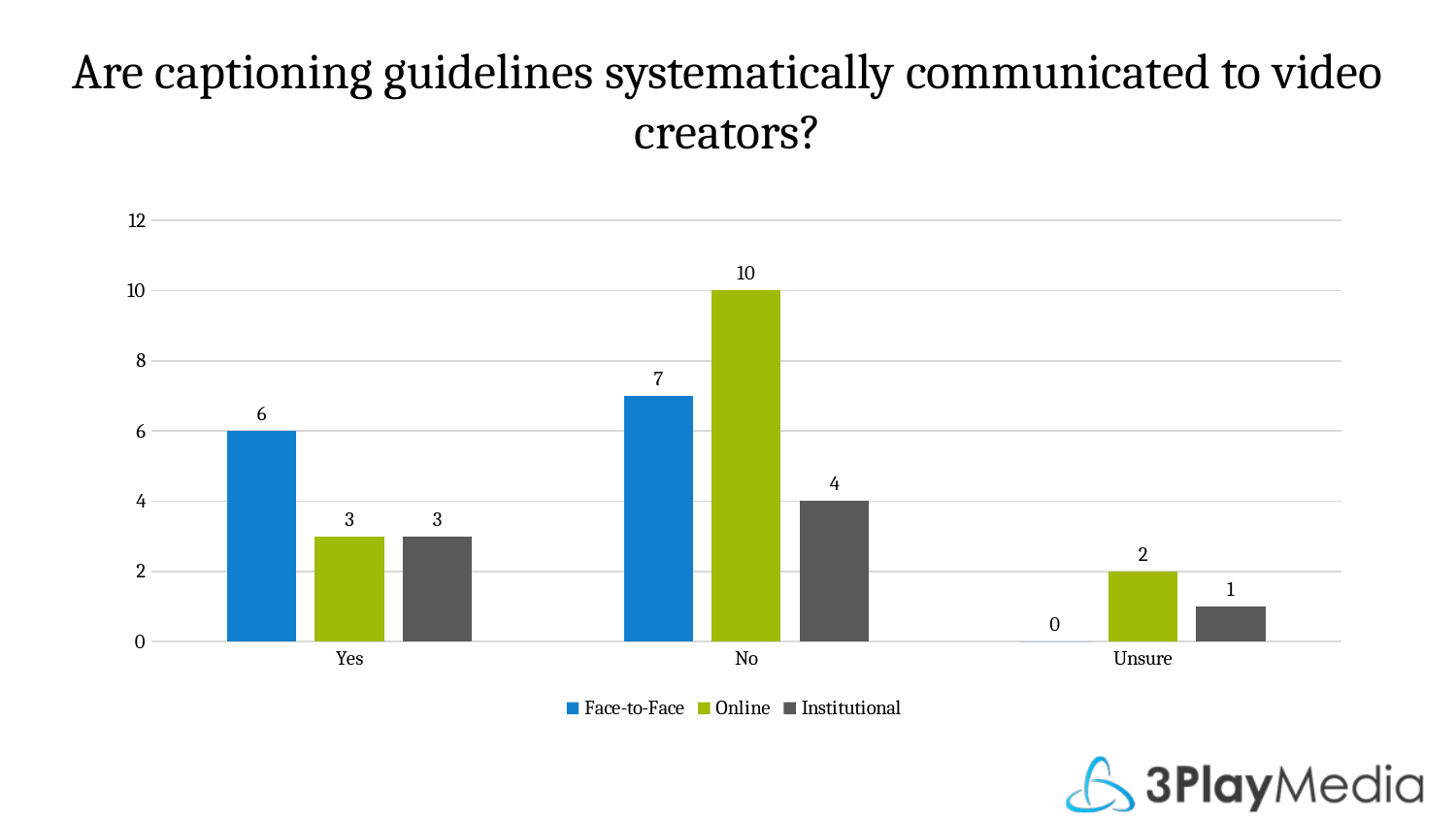
What is the value for Face-to-Face in the Unsure category? 0 Which category has the lowest value for the Face-to-Face series? Unsure Which category has the highest value for the Online series? No What is the title of the chart? Are captioning guidelines systematically communicated to video creators? How many series does the legend list? 3 Which is larger in the Yes category: Face-to-Face or Online? Face-to-Face What is the difference between the Online and Face-to-Face values in the No category? 3 What is the value for Online in the No category? 10 How many categories are shown on the x axis? 3 What is the value for Face-to-Face in the Yes category? 6 What kind of chart is shown on the slide? Bar chart What is the value for Institutional in the Unsure category? 1